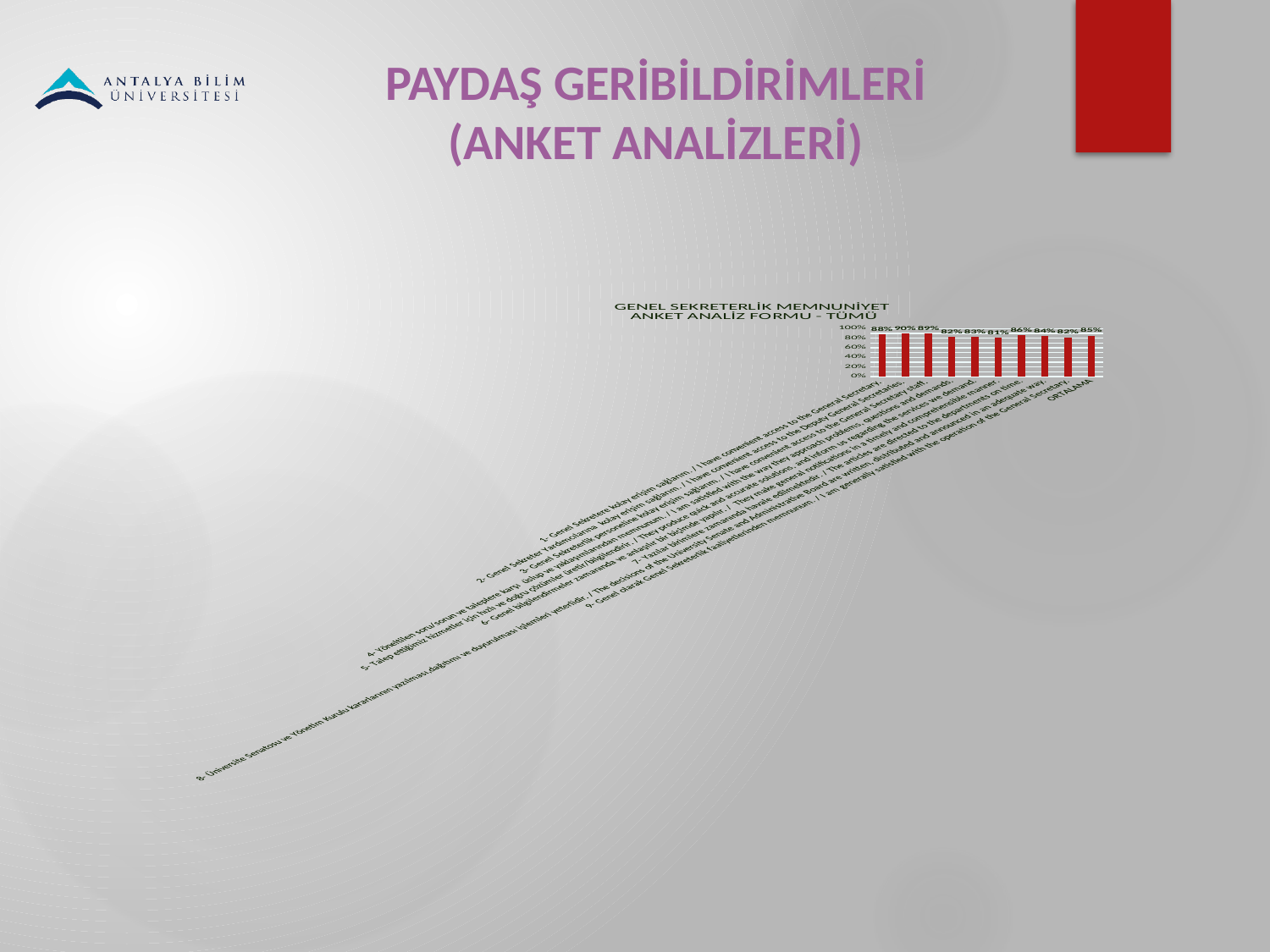
What is the value shown for item 2 (Genel Sekreter Yardımcılarına kolay erişim sağlanır)? 90% What kind of chart is shown on the slide? Bar chart How many bars are plotted in the chart? 10 Which is larger: the value for item 1 (88%) or the value for item 4 (82%)? Item 1 (88%) What is the difference between the highest value (90%) and the lowest value (81%) in the chart? 9 percentage points What is the value shown for item 6 (Genel bilgilendirmeler zamanında ve anlaşılır bir biçimde yapılır)? 81% What is the value shown for item 1 (Genel Sekretere kolay erişim sağlanır) in the chart? 88% Which category has the highest value in the chart? 2- Genel Sekreter Yardımcılarına kolay erişim sağlarım (90%) What is the value of the ORTALAMA bar in the chart? 85% What is the title of the chart? GENEL SEKRETERLİK MEMNUNİYET ANKET ANALİZ FORMU – TÜMÜ Which category has the lowest value in the chart? 6- Genel bilgilendirmeler zamanında ve anlaşılır bir biçimde yapılır (81%) Is the value for item 7 greater or less than 80%? greater